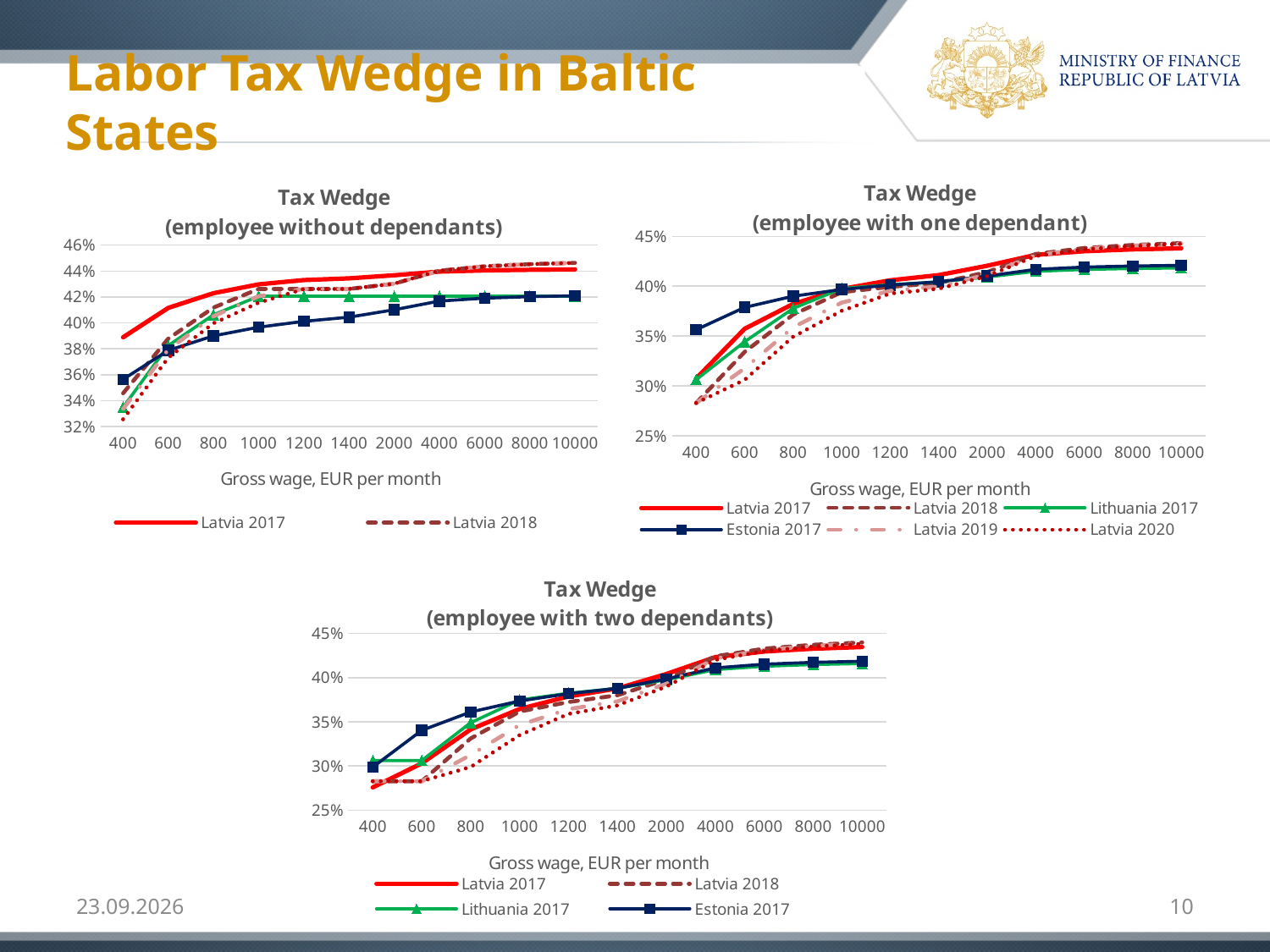
In the 'Tax Wedge (employee with one dependant)' chart, how many series does the legend list? 6 What kind of chart is the 'Tax Wedge (employee without dependants)' chart? line chart In the 'Tax Wedge (employee with one dependant)' chart, which is larger at a gross wage of 10000: Latvia 2017 or Estonia 2017? Latvia 2017 In the 'Tax Wedge (employee without dependants)' chart, does the Latvia 2017 line rise or fall as gross wage increases? rises In the 'Tax Wedge (employee without dependants)' chart, how many series does the legend list? 2 In the 'Tax Wedge (employee with two dependants)' chart, is the value for Latvia 2017 at a gross wage of 400 greater or less than 30%? less In the 'Tax Wedge (employee without dependants)' chart, how many gross wage levels are shown on the x axis? 11 In the 'Tax Wedge (employee with one dependant)' chart, which series has the highest value at a gross wage of 400? Estonia 2017 In the 'Tax Wedge (employee with two dependants)' chart, how many series does the legend list? 4 In the 'Tax Wedge (employee with one dependant)' chart, is the value for Latvia 2017 at a gross wage of 400 greater or less than 35%? less In the 'Tax Wedge (employee without dependants)' chart, is the value for Latvia 2017 at a gross wage of 400 greater or less than 36%? greater